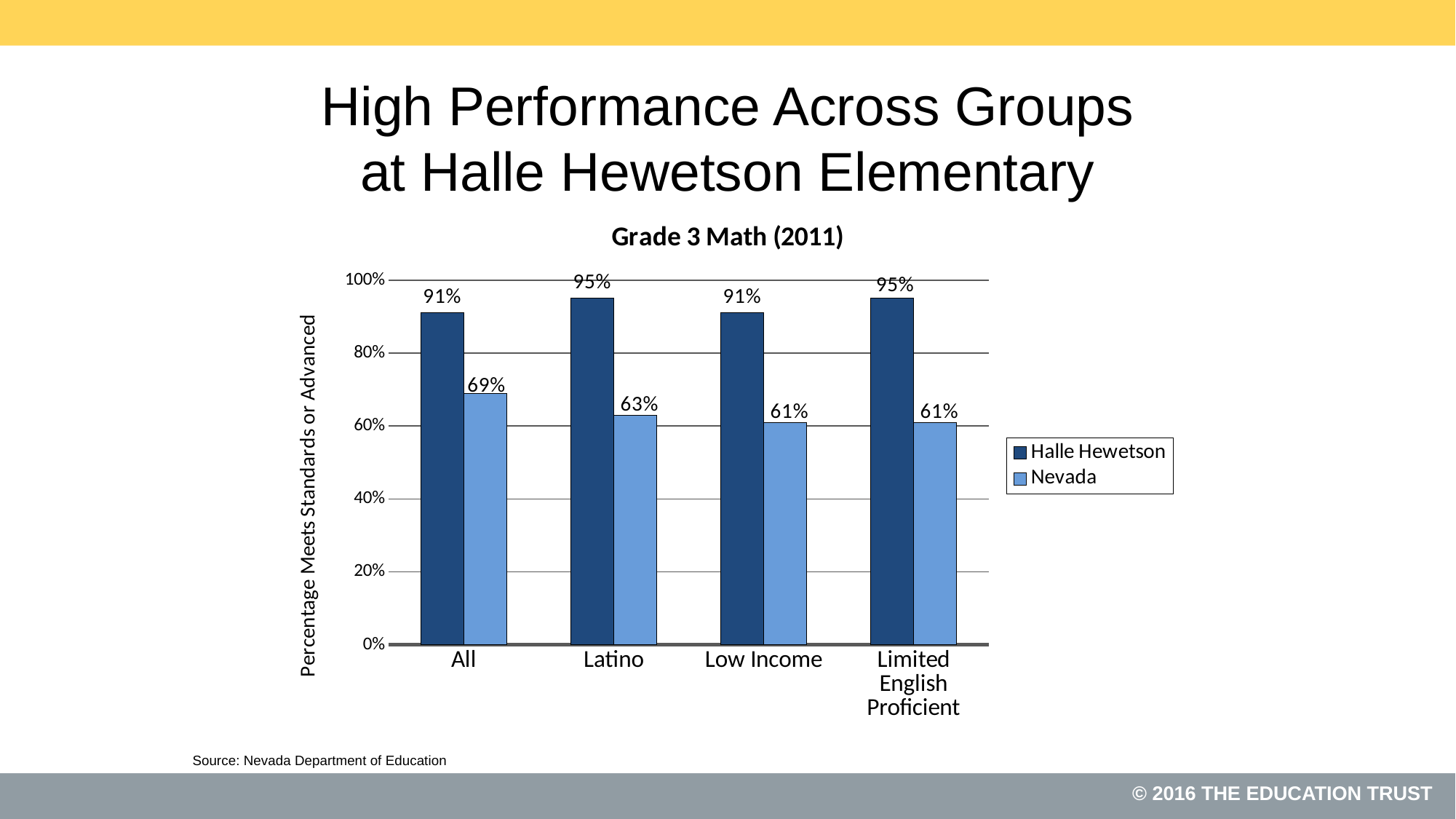
What kind of chart is shown on the slide? Bar chart What is the Halle Hewetson value for the Limited English Proficient group? 95% How many series does the legend list? 2 What is the difference between the Halle Hewetson and Nevada values for the All group? 22% What is the Halle Hewetson value for the Latino group? 95% What is the difference between the Halle Hewetson and Nevada values for the Limited English Proficient group? 34% What is the title of the chart? Grade 3 Math (2011) How many groups are shown on the x axis? 4 Which is larger for the Low Income group, the Halle Hewetson value or the Nevada value? Halle Hewetson What is the Nevada value for the All group? 69% What is the Nevada value for the Low Income group? 61% Which group has the highest Nevada value? All